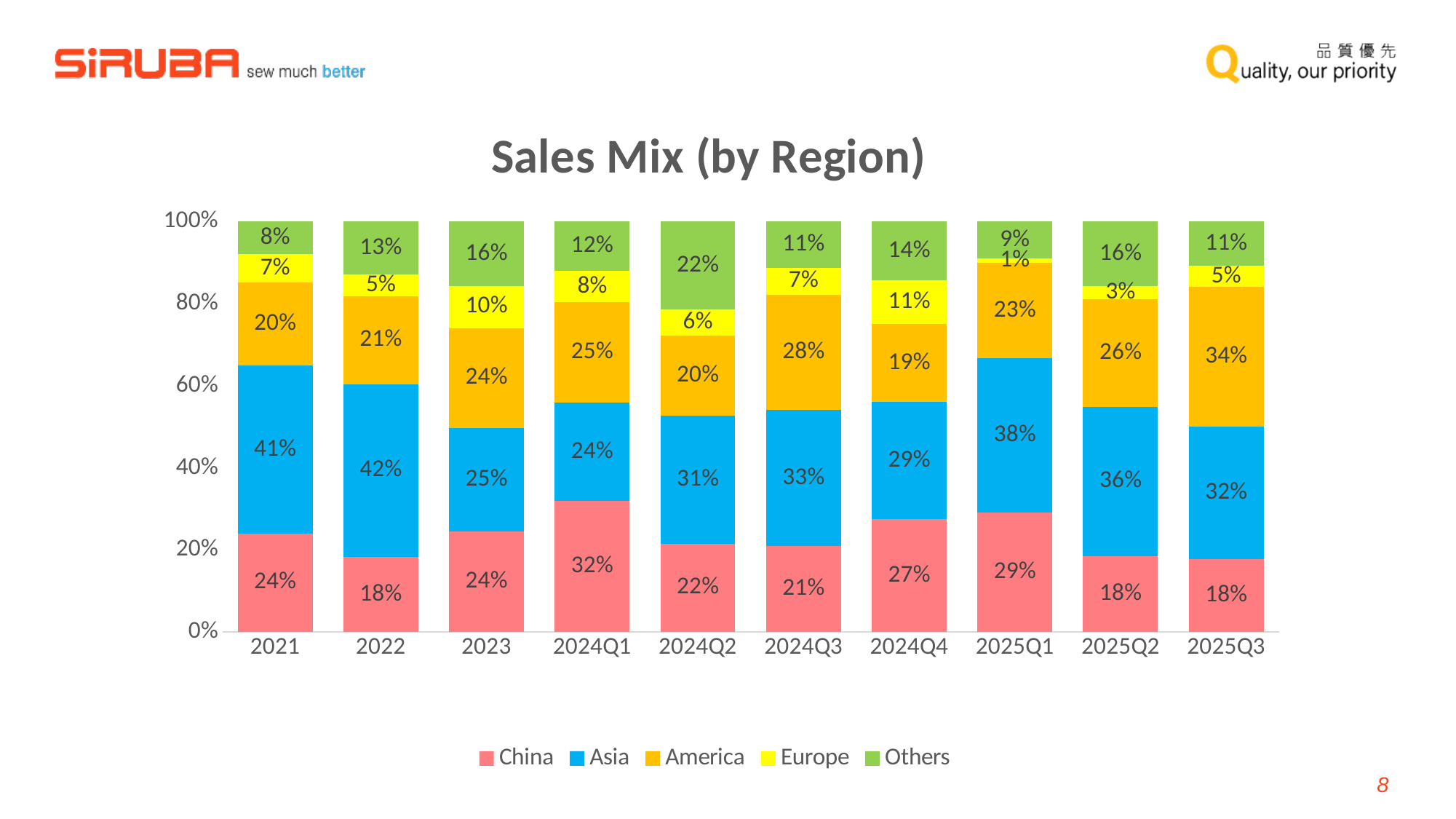
How many periods are shown on the x axis? 10 How many series does the legend list? 5 What is the Europe share in 2025Q1? 1% What is the difference between the Asia share in 2022 and the Asia share in 2023? 17% What is the title of the chart? Sales Mix (by Region) In which period is the China share highest? 2024Q1 In which period is the Europe share lowest? 2025Q1 What is the China share in 2024Q1? 32% What is the Others share in 2024Q2? 22% What kind of chart is shown? Stacked bar chart Which is larger in 2025Q3, the Asia share or the America share? America What is the America share in 2025Q3? 34%